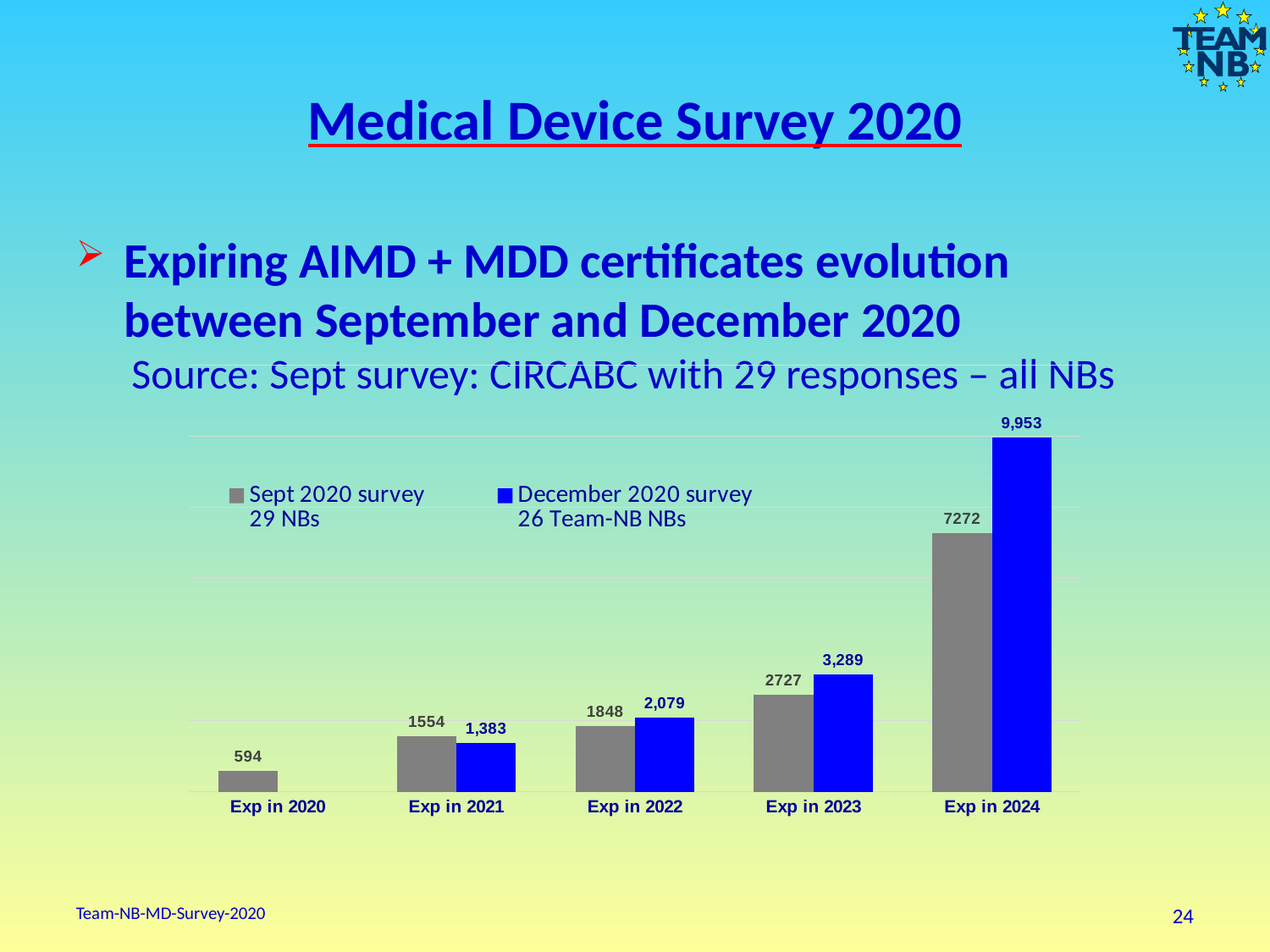
What is the December 2020 survey value for Exp in 2022? 2,079 How many series does the legend list? 2 How many categories are shown on the x axis? 5 Which category has the lowest December 2020 survey value? Exp in 2021 For Exp in 2023, which series has the larger value, Sept 2020 survey or December 2020 survey? December 2020 survey What is the difference between the December 2020 survey and Sept 2020 survey values for Exp in 2024? 2681 What kind of chart is shown on the slide? Bar chart Which category has the highest Sept 2020 survey value? Exp in 2024 What is the Sept 2020 survey value for Exp in 2023? 2727 What is the difference between the Sept 2020 survey and December 2020 survey values for Exp in 2021? 171 What is the December 2020 survey value for Exp in 2024? 9,953 What is the Sept 2020 survey value for Exp in 2020? 594